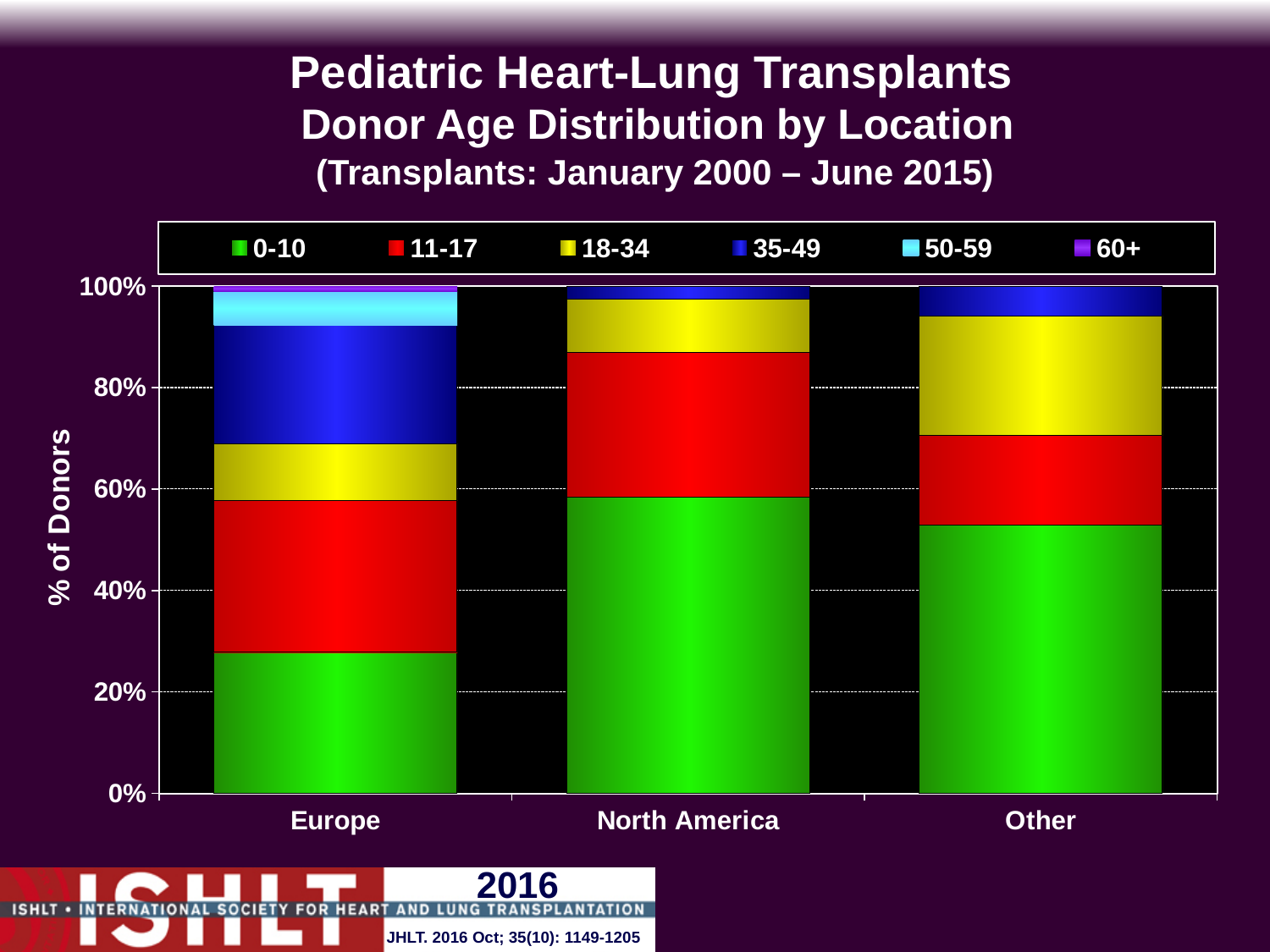
What is the label on the y axis? % of Donors What kind of chart is shown on the slide? Stacked bar chart Is the 0-10 share of donors for Europe greater or less than 40%? less Which location has the smallest 0-10 share of donors? Europe How many donor age groups does the legend list? 6 Is the 0-10 share of donors for Europe greater or less than 20%? greater Which has a larger 0-10 share of donors, Europe or North America? North America What is the total height of the North America stacked bar? 100% Which location is the only one with a 60+ donor age segment? Europe Which location has the largest 35-49 share of donors? Europe How many locations are shown on the x axis? 3 Is the 0-10 share of donors for North America greater or less than 40%? greater